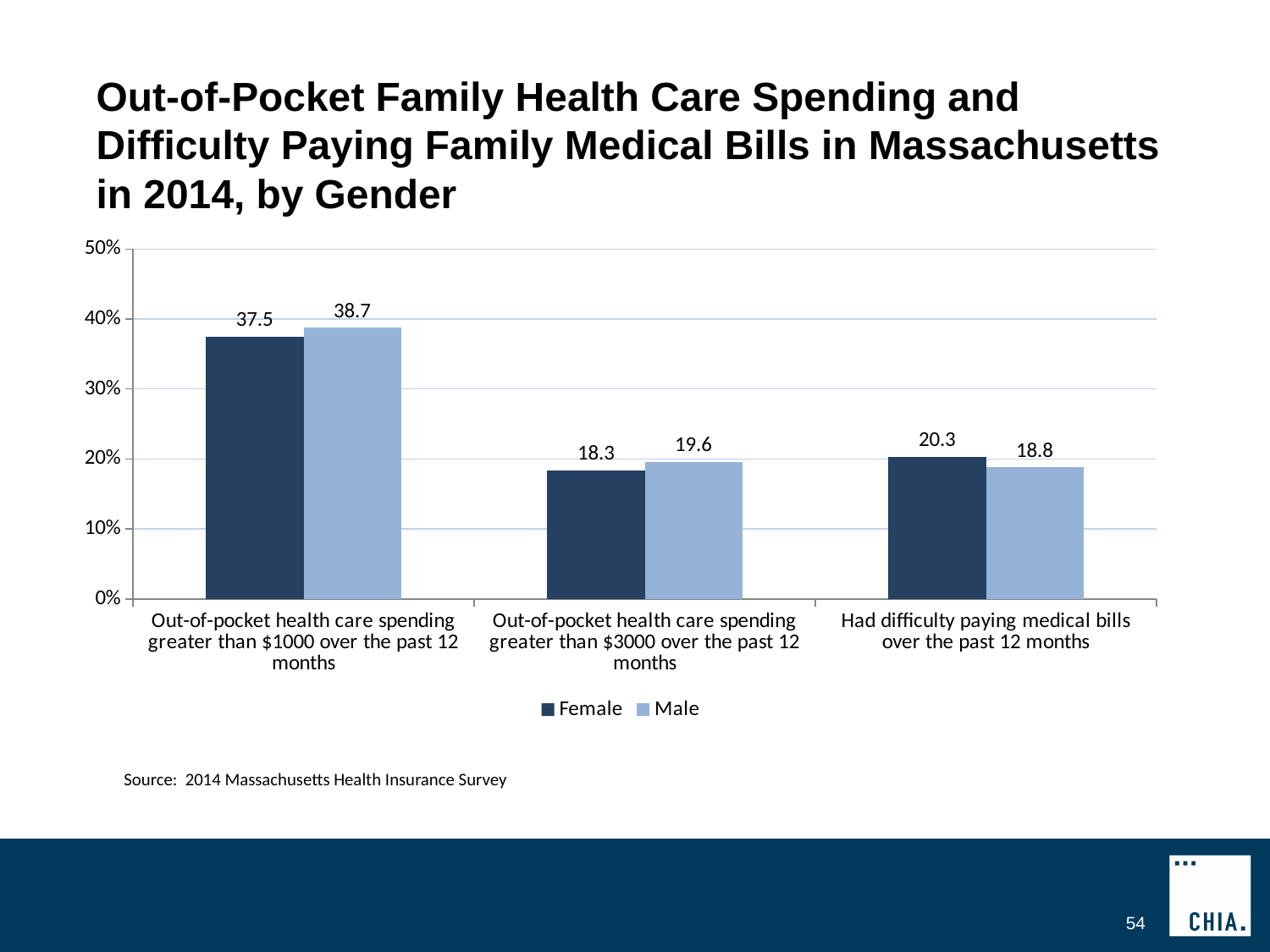
What is the source cited below the chart? 2014 Massachusetts Health Insurance Survey What is the difference between the Male and Female values for 'Out-of-pocket health care spending greater than $1000 over the past 12 months'? 1.2 What is the Female value for 'Had difficulty paying medical bills over the past 12 months'? 20.3 How many series does the legend list? 2 Which category has the highest Male value? Out-of-pocket health care spending greater than $1000 over the past 12 months What is the Female value for 'Out-of-pocket health care spending greater than $1000 over the past 12 months'? 37.5 How many categories are shown on the x axis? 3 What kind of chart is shown on the slide? Bar chart Is the Female value for 'Out-of-pocket health care spending greater than $1000 over the past 12 months' greater or less than 30%? greater What is the Male value for 'Out-of-pocket health care spending greater than $3000 over the past 12 months'? 19.6 For 'Had difficulty paying medical bills over the past 12 months', which is larger, the Female or the Male value? Female Which category has the lowest Female value? Out-of-pocket health care spending greater than $3000 over the past 12 months